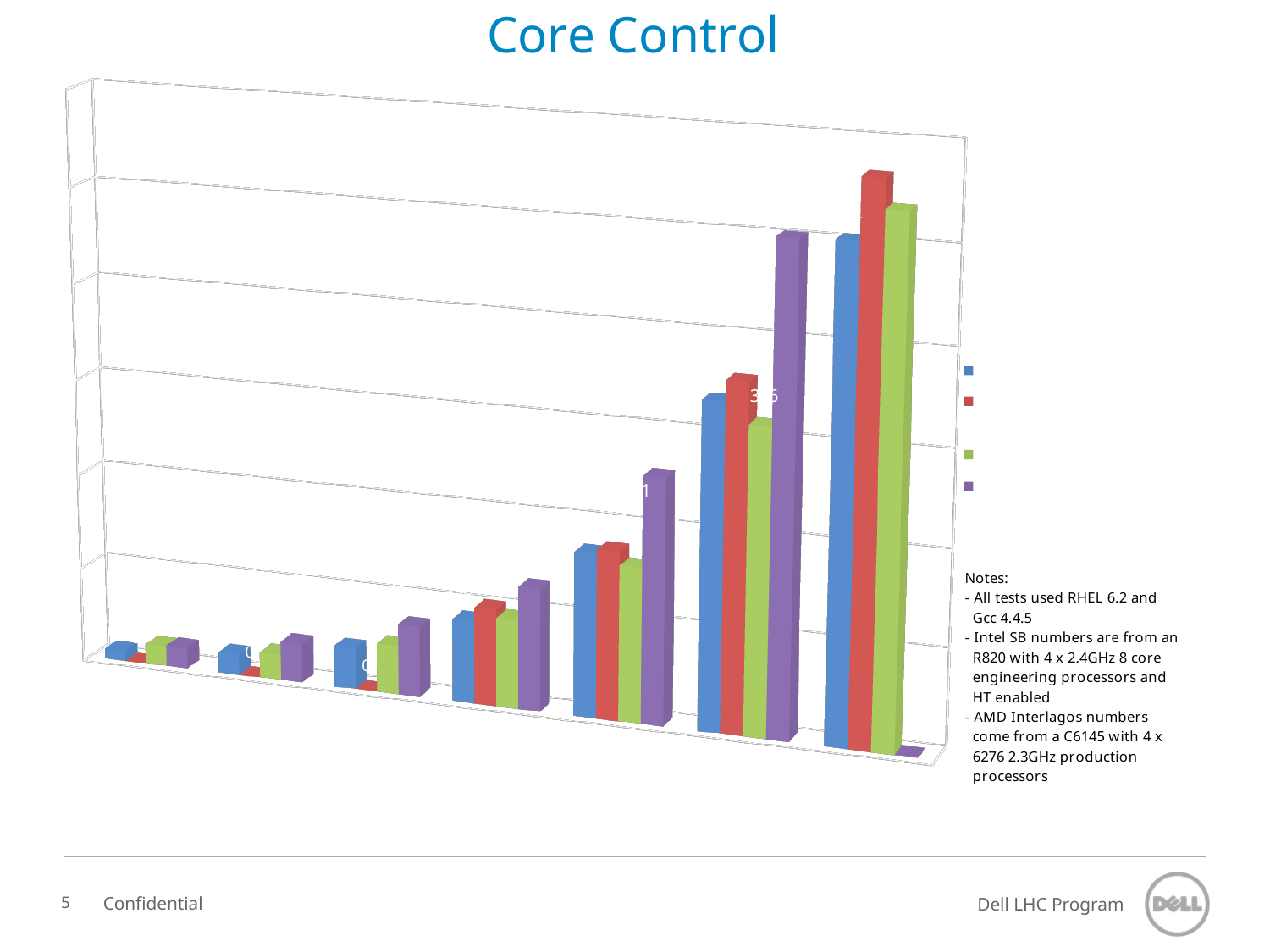
What colours are used for the four series in the chart? blue, red, green, purple What kind of chart is shown on the slide? bar chart How many series does the legend list? 4 Do the bar values generally rise or fall from left to right along the x axis? rise How many groups of bars (categories) are plotted along the x axis? 7 What is the title of the slide containing the chart? Core Control